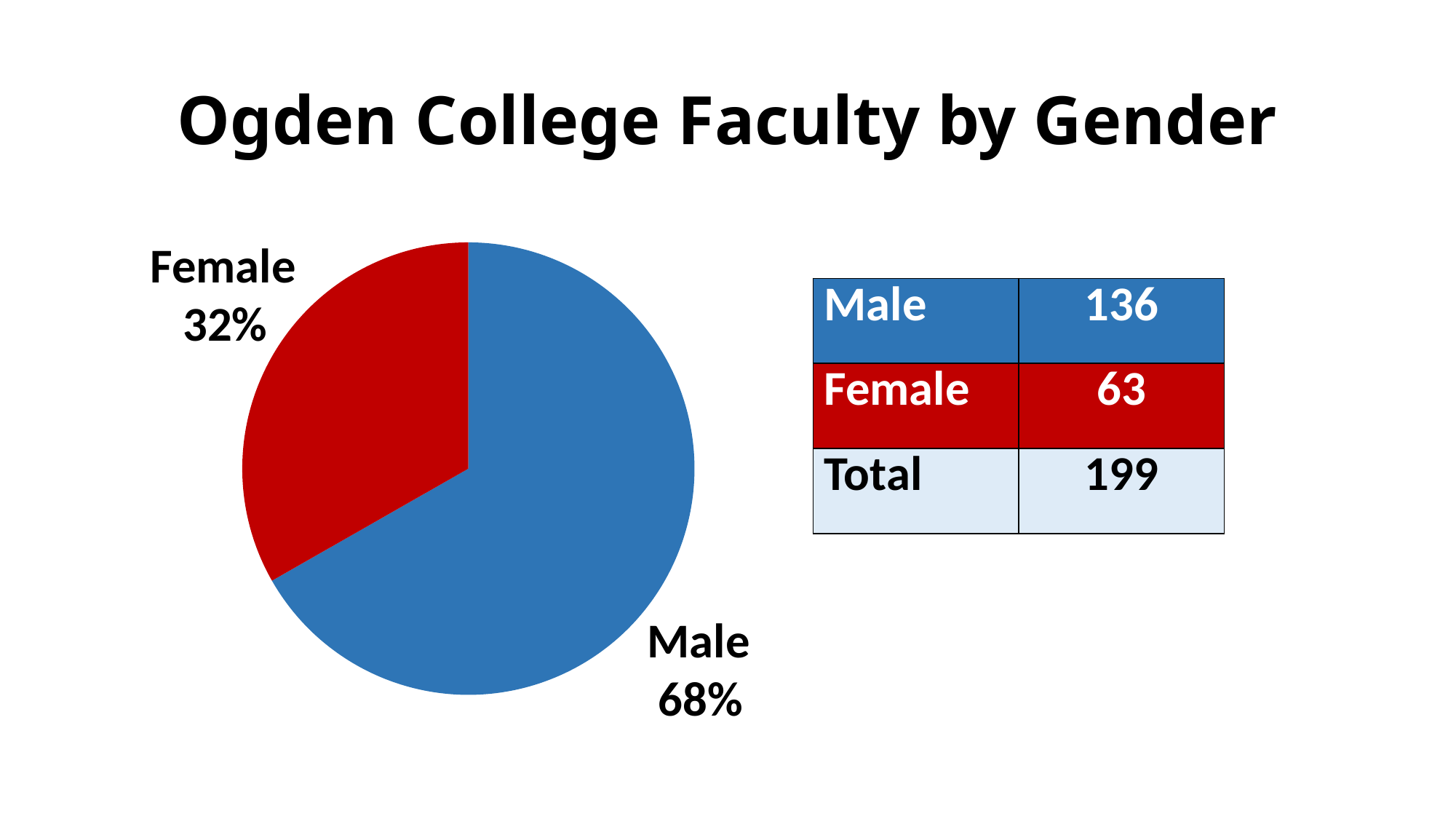
What kind of chart is shown on the slide? pie chart How many slices does the pie chart have? 2 Which slice of the pie chart is the smallest? Female What is the difference in percentage points between the Male and Female slices? 36 What is the title of the slide? Ogden College Faculty by Gender Which slice is larger, Male or Female? Male Which slice of the pie chart is the largest? Male What percentage of the pie chart is labelled Male? 68% What percentage of the pie chart is labelled Female? 32% What colour is the Female slice of the pie chart? red Is the Male share of the pie chart greater or less than 50%? greater